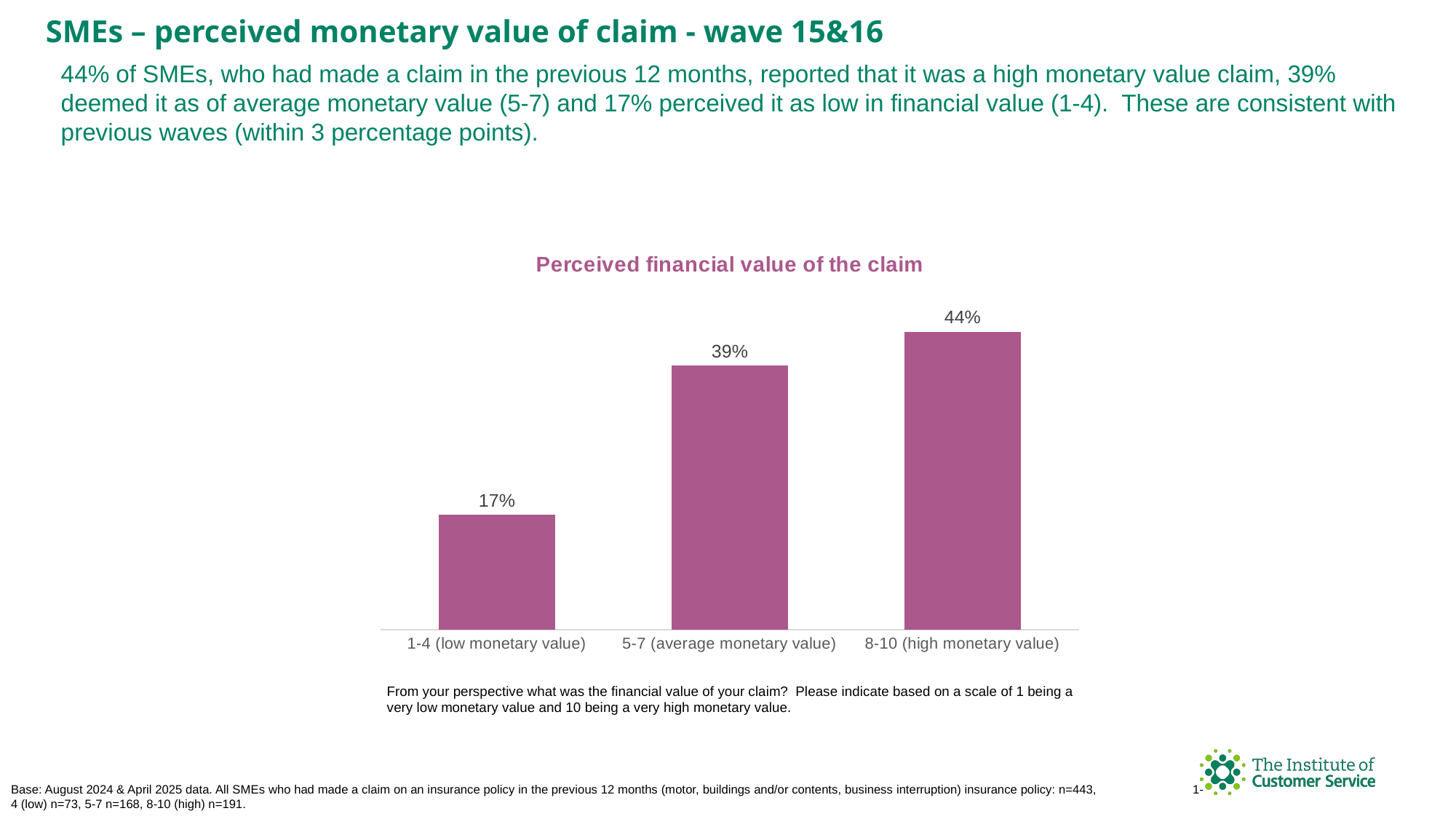
What is the difference between the values for 8-10 (high monetary value) and 1-4 (low monetary value)? 27% What kind of chart is shown on the slide? Bar chart What is the value for 5-7 (average monetary value)? 39% Which category has the lowest value? 1-4 (low monetary value) Do the values rise or fall from left to right along the x axis? Rise What is the value for 1-4 (low monetary value)? 17% What is the value for 8-10 (high monetary value)? 44% Which is larger, the value for 5-7 (average monetary value) or 8-10 (high monetary value)? 8-10 (high monetary value) Which category has the highest value? 8-10 (high monetary value) How many categories are shown in the chart? 3 What is the difference between the values for 5-7 (average monetary value) and 1-4 (low monetary value)? 22% What is the title of the chart? Perceived financial value of the claim